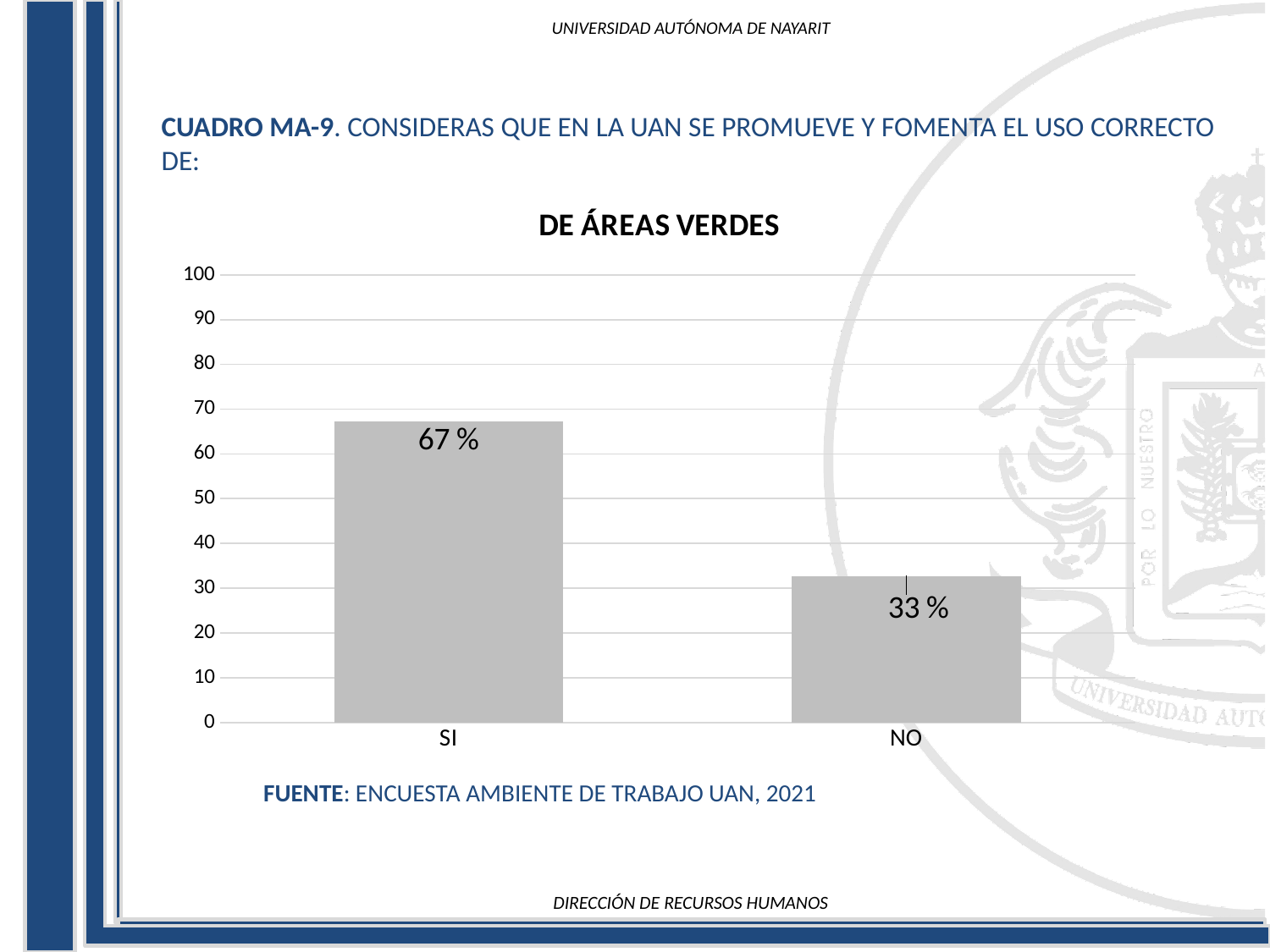
Which category has the lowest value? NO What kind of chart is shown on the slide? bar chart Which category has the highest value? SI Which is larger, the value for SI or the value for NO? SI How many categories are shown on the x axis? 2 What is the value for NO? 33 % What is the value for SI? 67 % Is the value for SI greater or less than 50? greater What is the difference between the values for SI and NO? 34 % What is the maximum value shown on the y axis? 100 Is the value for NO greater or less than 40? less What is the title of the chart? DE ÁREAS VERDES